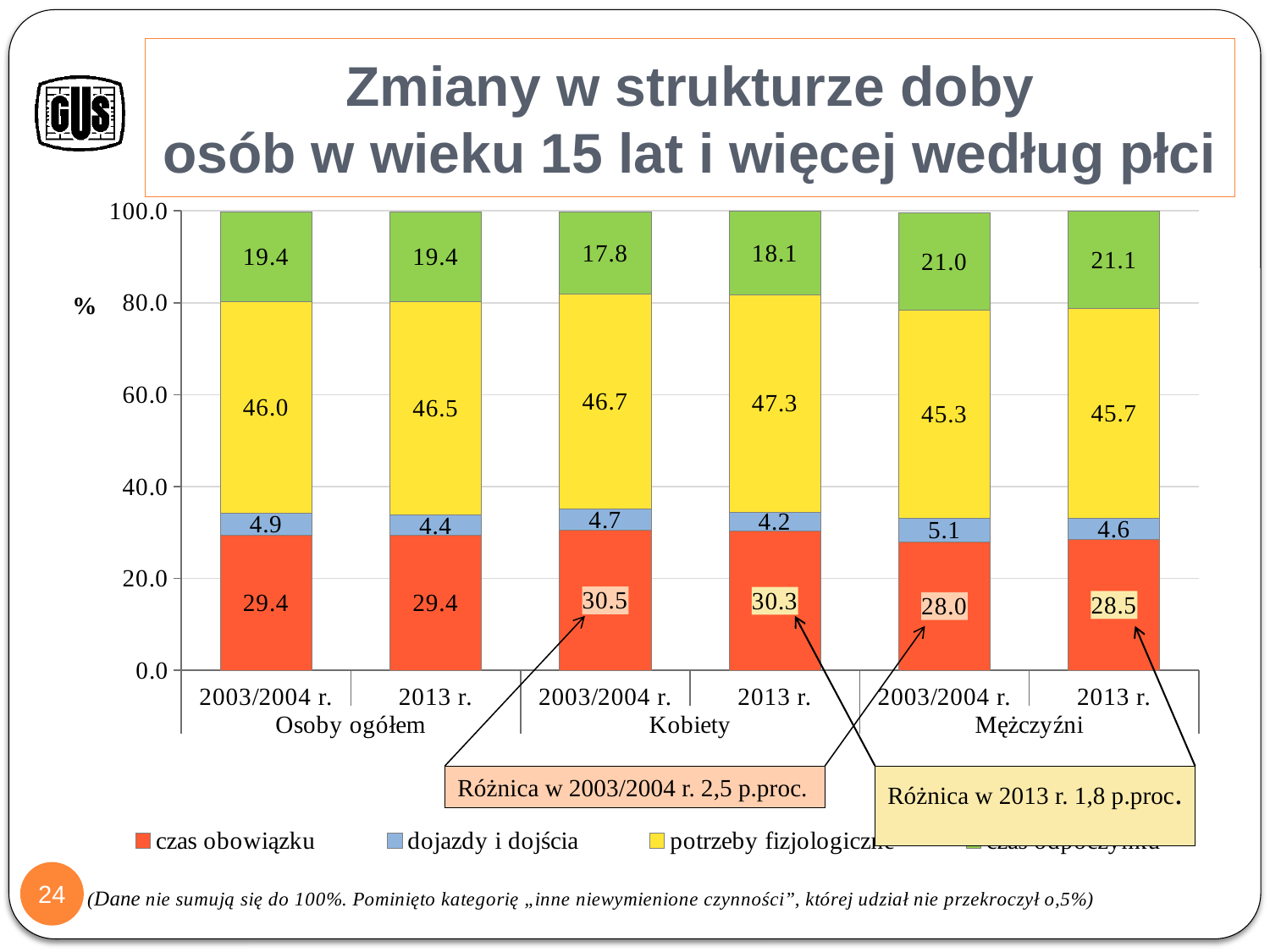
Which bar has the highest value for czas obowiązku? Kobiety 2003/2004 r. How many series does the legend list? 4 How many bars are plotted in the chart? 6 What is the value of potrzeby fizjologiczne for Mężczyźni in 2013 r.? 45.7 What is the difference between czas obowiązku for Kobiety and for Mężczyźni in 2013 r.? 1.8 Which bar has the lowest value for dojazdy i dojścia? Kobiety 2013 r. Which is larger: potrzeby fizjologiczne for Kobiety in 2013 r. or for Mężczyźni in 2013 r.? Kobiety in 2013 r. What is the value of the green segment for Mężczyźni in 2003/2004 r.? 21.0 What is the value of czas obowiązku for Kobiety in 2003/2004 r.? 30.5 What is the difference between czas obowiązku for Kobiety and for Mężczyźni in 2003/2004 r.? 2.5 What is the value of dojazdy i dojścia for Osoby ogółem in 2013 r.? 4.4 What type of chart is shown on the slide? stacked bar chart